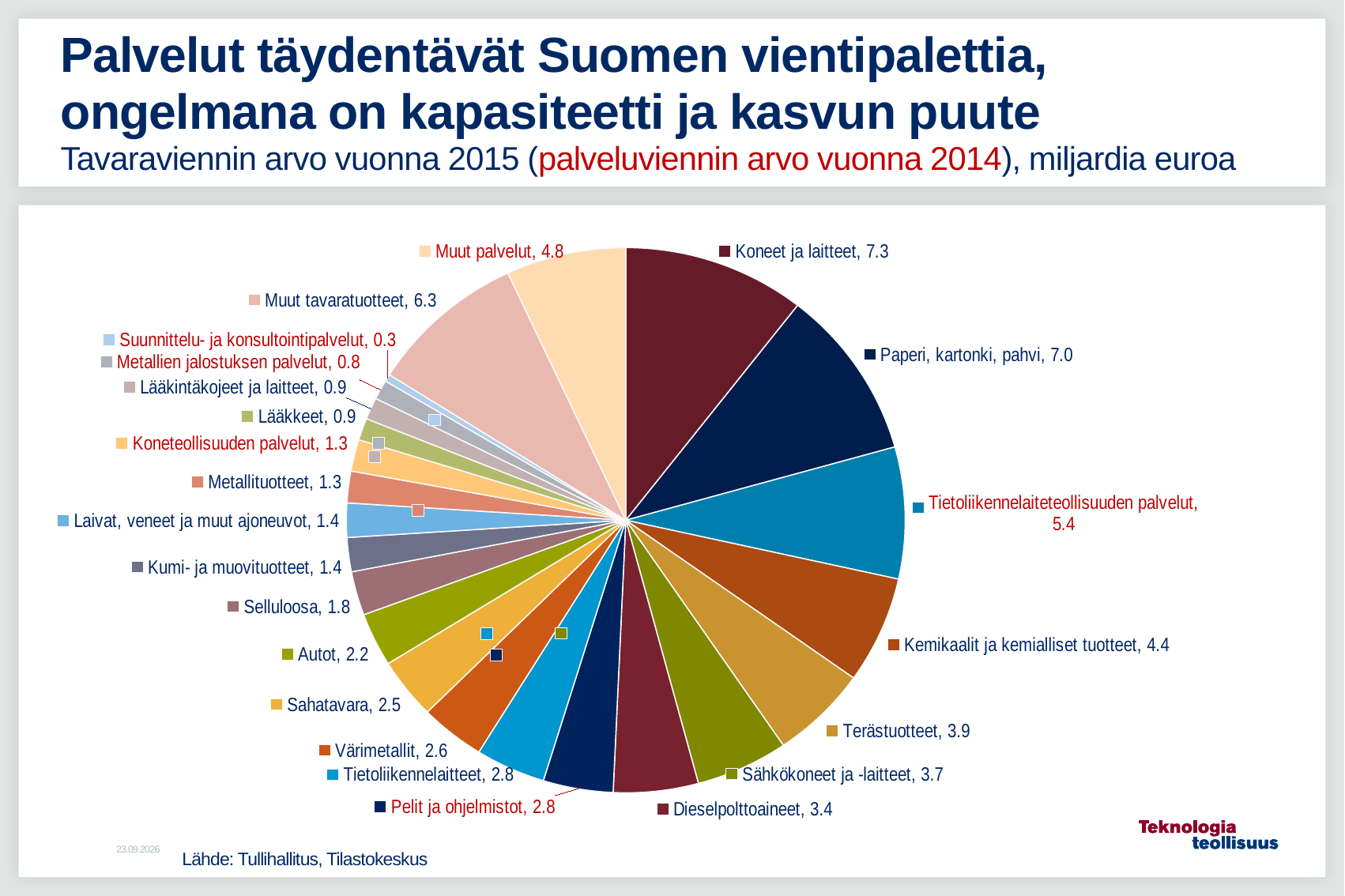
What is the source cited below the chart? Tullihallitus, Tilastokeskus What is the value for Muut palvelut? 4.8 How many slices does the pie chart have? 23 What is the difference between Kemikaalit ja kemialliset tuotteet and Terästuotteet? 0.5 What type of chart is shown on the slide? pie chart Which category has the smallest value in the pie chart? Suunnittelu- ja konsultointipalvelut Which is larger, Sahatavara or Autot? Sahatavara What is the value for Koneet ja laitteet? 7.3 Which category has the largest value in the pie chart? Koneet ja laitteet What is the value for Dieselpolttoaineet? 3.4 What is the value for Tietoliikennelaiteteollisuuden palvelut? 5.4 What is the difference between Koneet ja laitteet and Paperi, kartonki, pahvi? 0.3